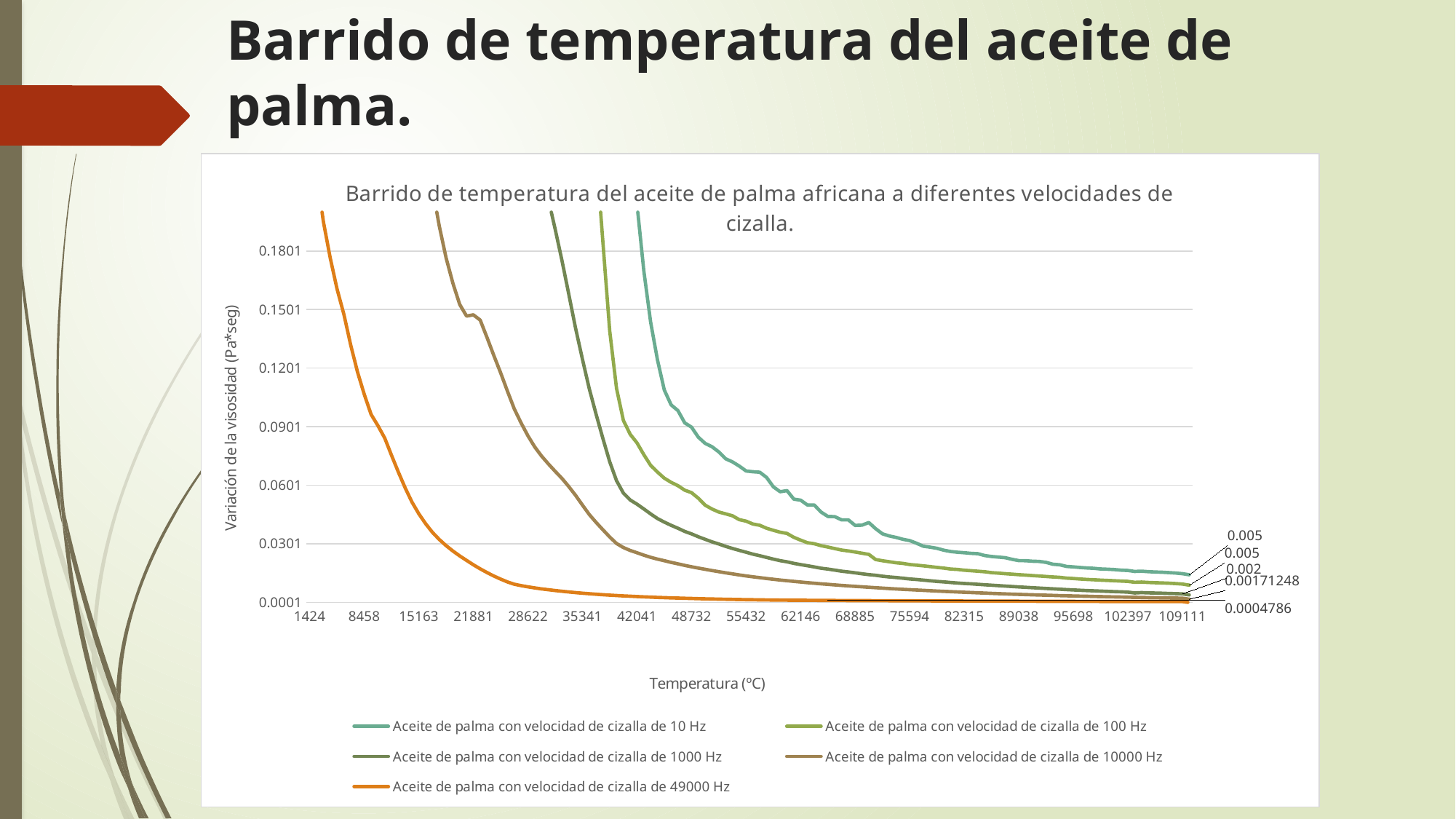
What is the smallest data label printed at the right end of the chart? 0.0004786 How many series does the legend list? 5 What is the last tick label on the x axis? 109111 What is the label of the vertical axis? Variación de la visosidad (Pa*seg) Is the value for the 49000 Hz series at 28622 greater or less than 0.0301? less What is the title of the chart? Barrido de temperatura del aceite de palma africana a diferentes velocidades de cizalla. At 42041, which is larger: the 10 Hz series or the 10000 Hz series? 10 Hz series Do the viscosity values rise or fall as you move along the x axis? fall Which series has the lowest viscosity across the chart? Aceite de palma con velocidad de cizalla de 49000 Hz What kind of chart is shown on the slide? line chart